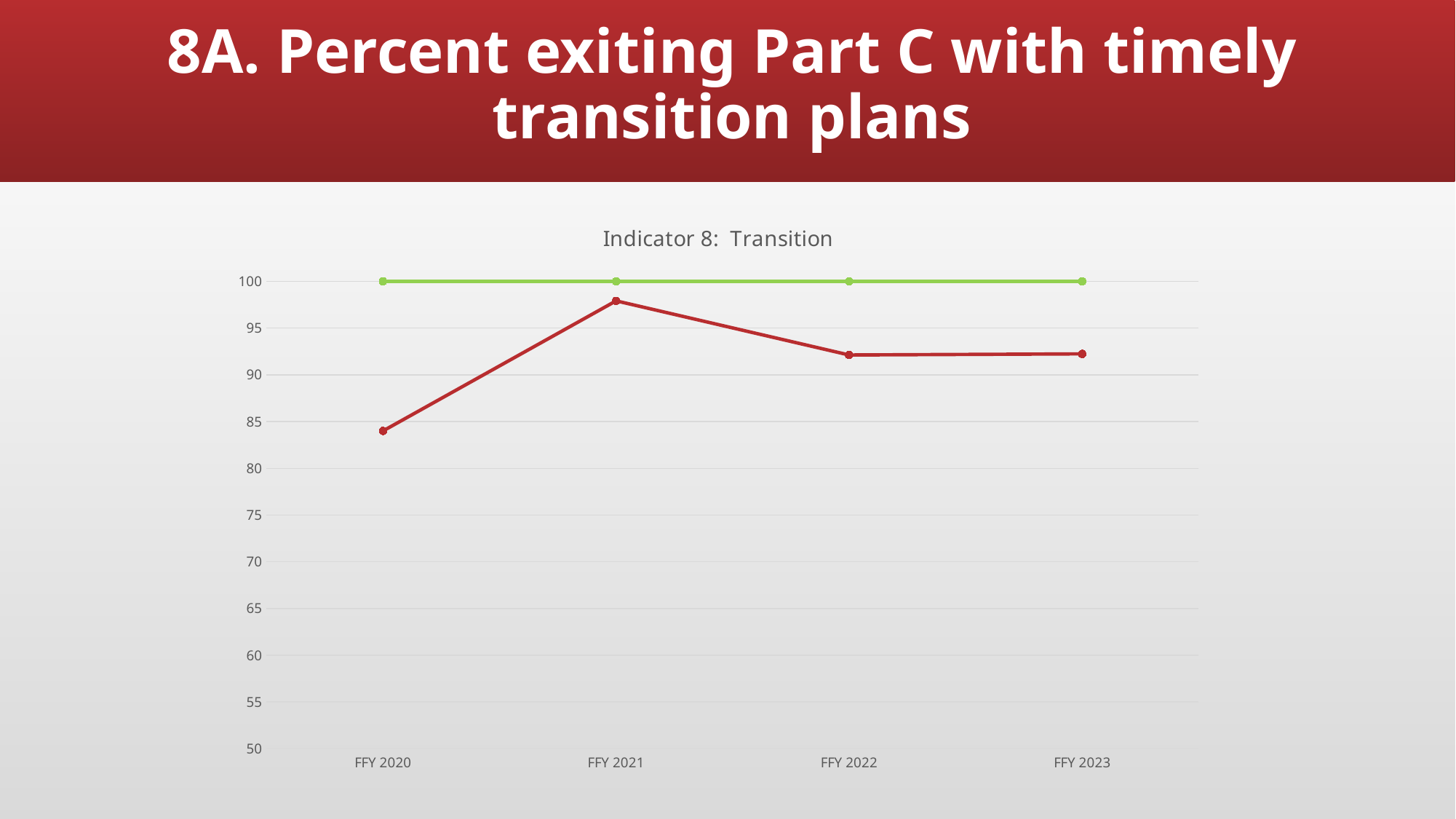
Which year has the larger red line value, FFY 2020 or FFY 2023? FFY 2023 In which year is the red line at its lowest? FFY 2020 Is the red line value for FFY 2021 greater or less than 95? greater In which year is the red line at its highest? FFY 2021 How many FFY categories are shown on the x axis? 4 Does the red line rise or fall from FFY 2021 to FFY 2022? fall Does the red line rise or fall from FFY 2020 to FFY 2021? rise Is the red line value for FFY 2020 greater or less than 85? less What value does the green line sit at across all years? 100 What is the title of the chart? Indicator 8: Transition Is the red line value for FFY 2022 greater or less than 90? greater What kind of chart is shown on the slide? line chart